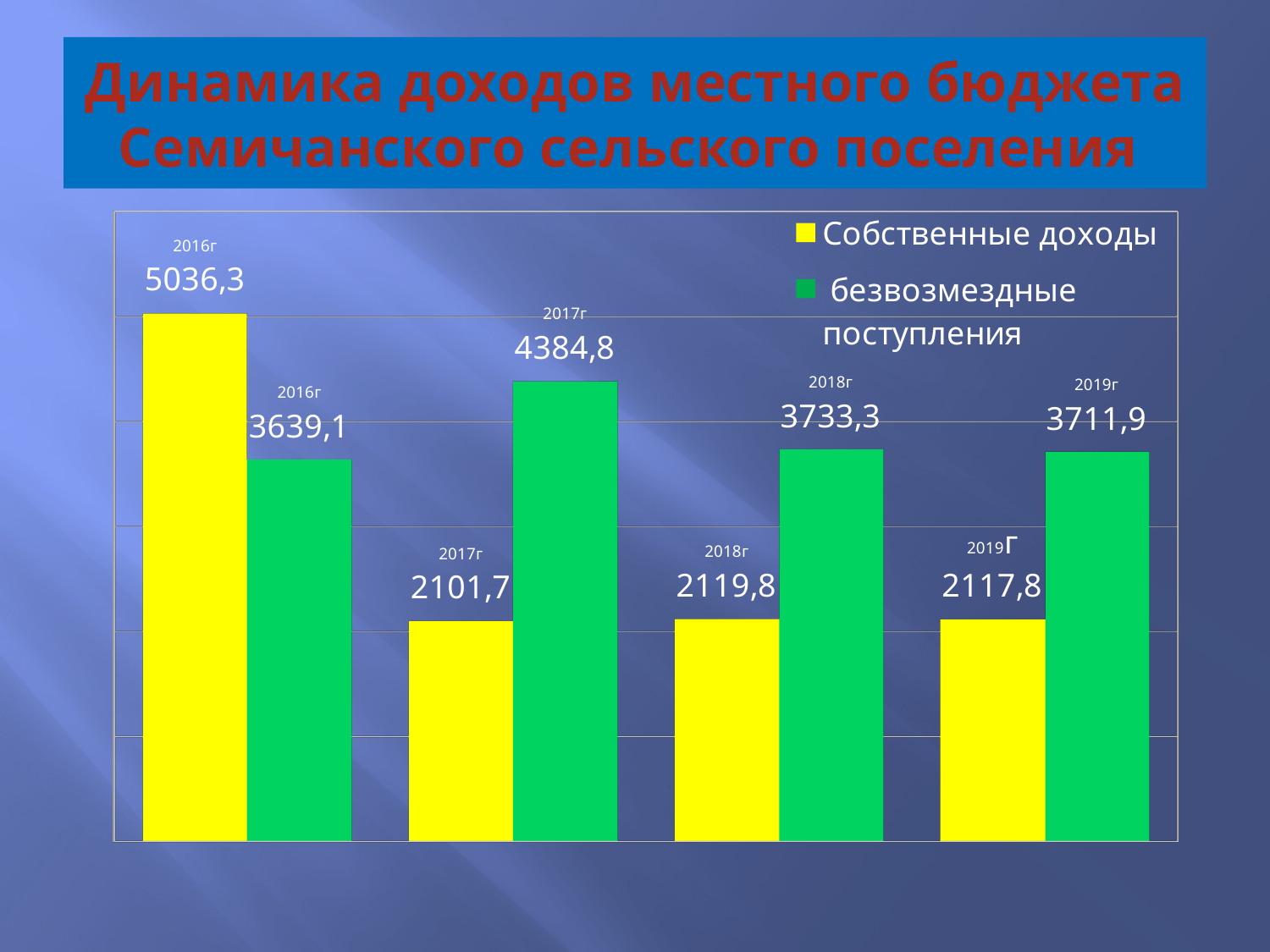
In which year is безвозмездные поступления the lowest? 2016г How many series does the legend list? 2 In which year is Собственные доходы the highest? 2016г What is the value of Собственные доходы for 2016г? 5036,3 What is the value of безвозмездные поступления for 2018г? 3733,3 What is the value of Собственные доходы for 2019г? 2117,8 What kind of chart is shown on the slide? bar chart How many years are shown on the chart? 4 What is the value of безвозмездные поступления for 2017г? 4384,8 What is the difference between Собственные доходы and безвозмездные поступления in 2016г? 1397,2 Which colour represents Собственные доходы in the chart? yellow Which is larger in 2017г: Собственные доходы or безвозмездные поступления? безвозмездные поступления